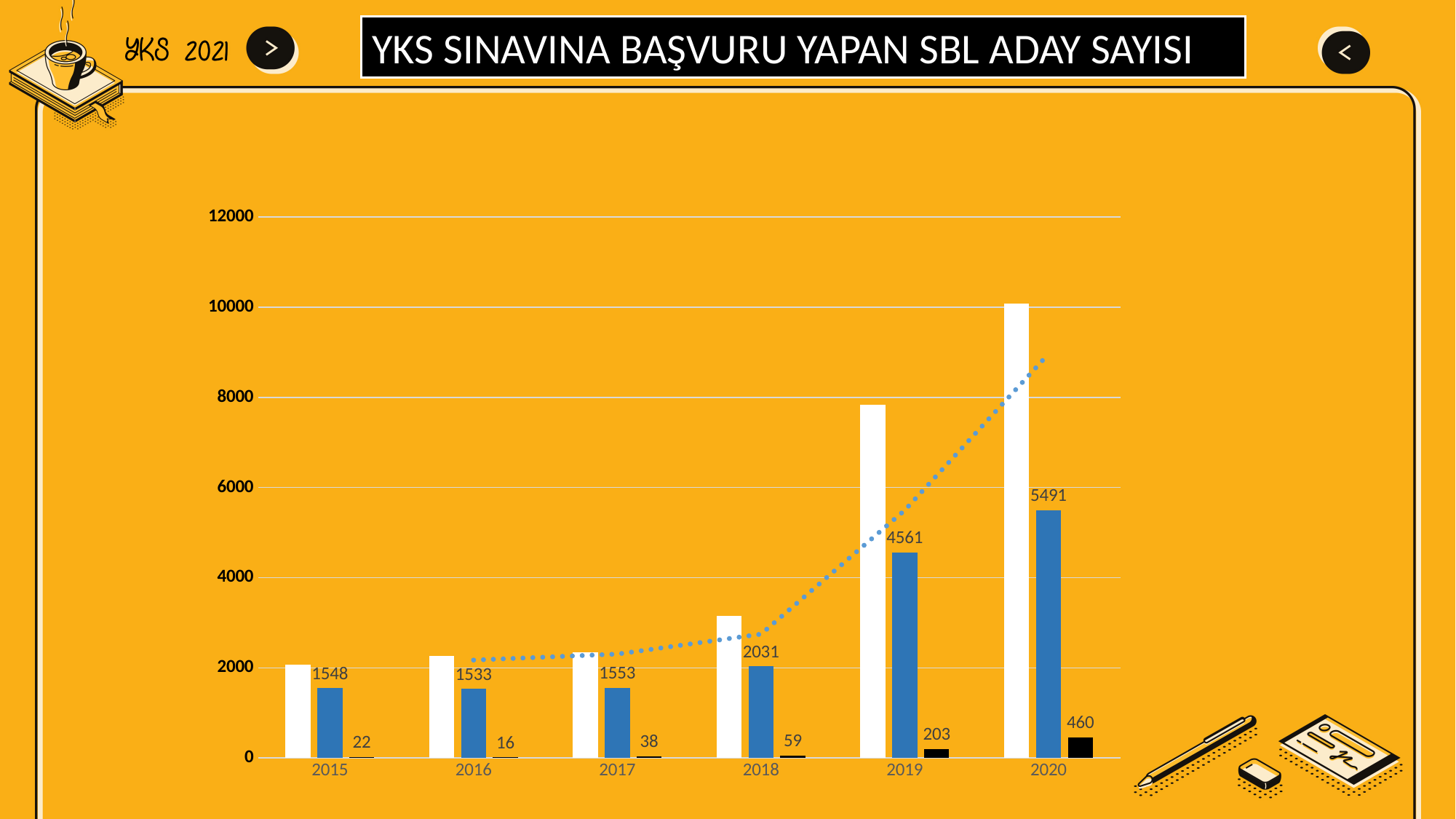
What is the difference between the blue bar values for 2020 and 2019? 930 Is the white bar for 2019 greater or less than 8000? less Which year has the lowest value for the black bars? 2016 What is the title of the chart? YKS SINAVINA BAŞVURU YAPAN SBL ADAY SAYISI What is the value of the black bar for 2016? 16 What is the value of the blue bar for 2018? 2031 How many years are shown on the x axis? 6 Which year has the highest value for the blue bars? 2020 What is the value of the blue bar for 2020? 5491 What is the value of the black bar for 2019? 203 What is the difference between the black bar values for 2020 and 2019? 257